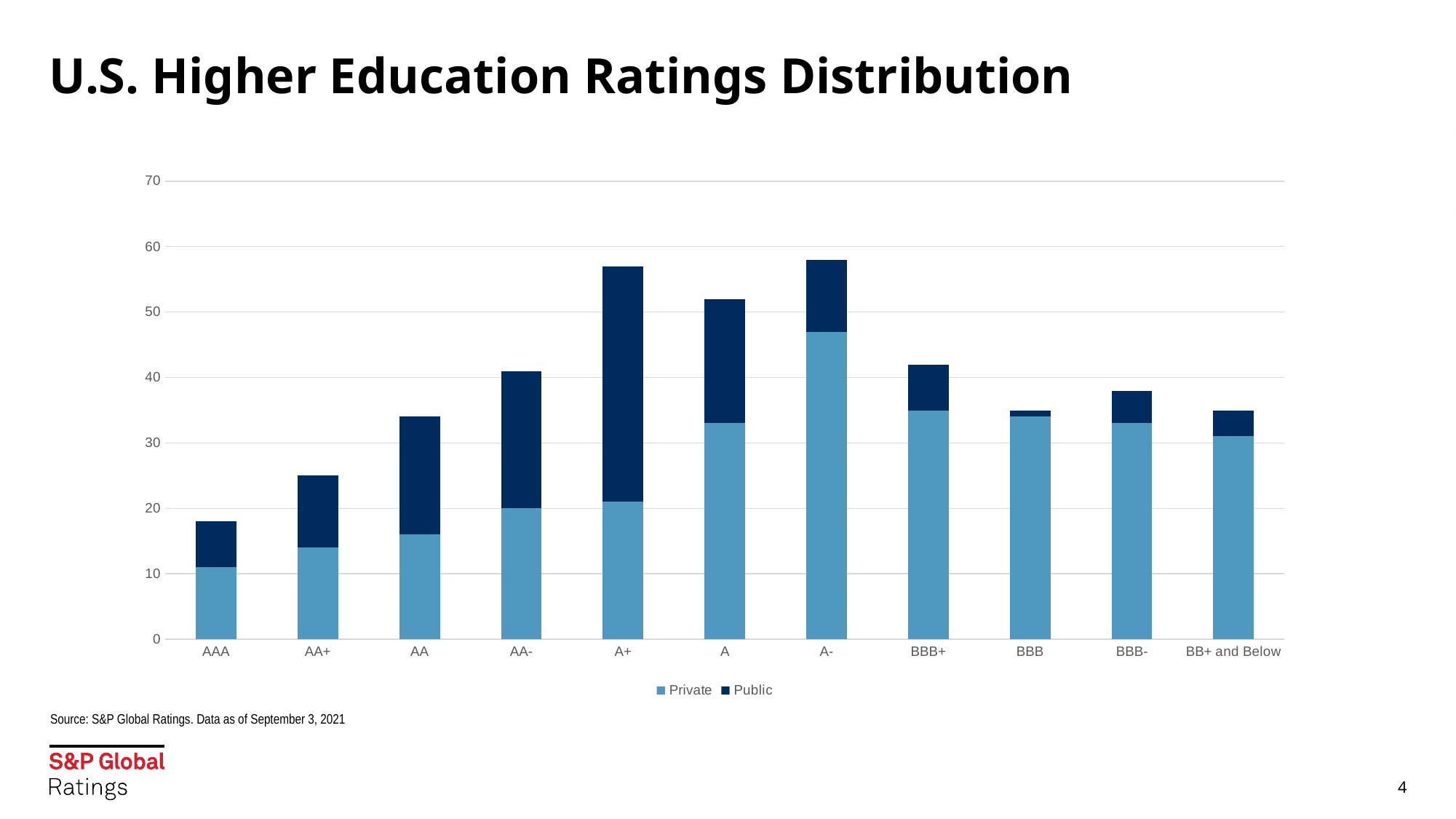
What kind of chart is shown on the slide? Stacked bar chart Which rating category has the largest Public segment? A+ Do the total bars rise or fall from AAA to A+? rise Which has the larger total bar, BBB+ or BBB? BBB+ How many rating categories are shown on the x axis? 11 How many series does the legend list? 2 Is the total bar for A+ greater or less than 50? greater Which rating category has the lowest total bar? AAA Which rating category has the smallest Public segment? BBB Which rating category has the largest Private segment? A- Is the total bar for AAA greater or less than 20? less Is the Private value for A- greater or less than 40? greater